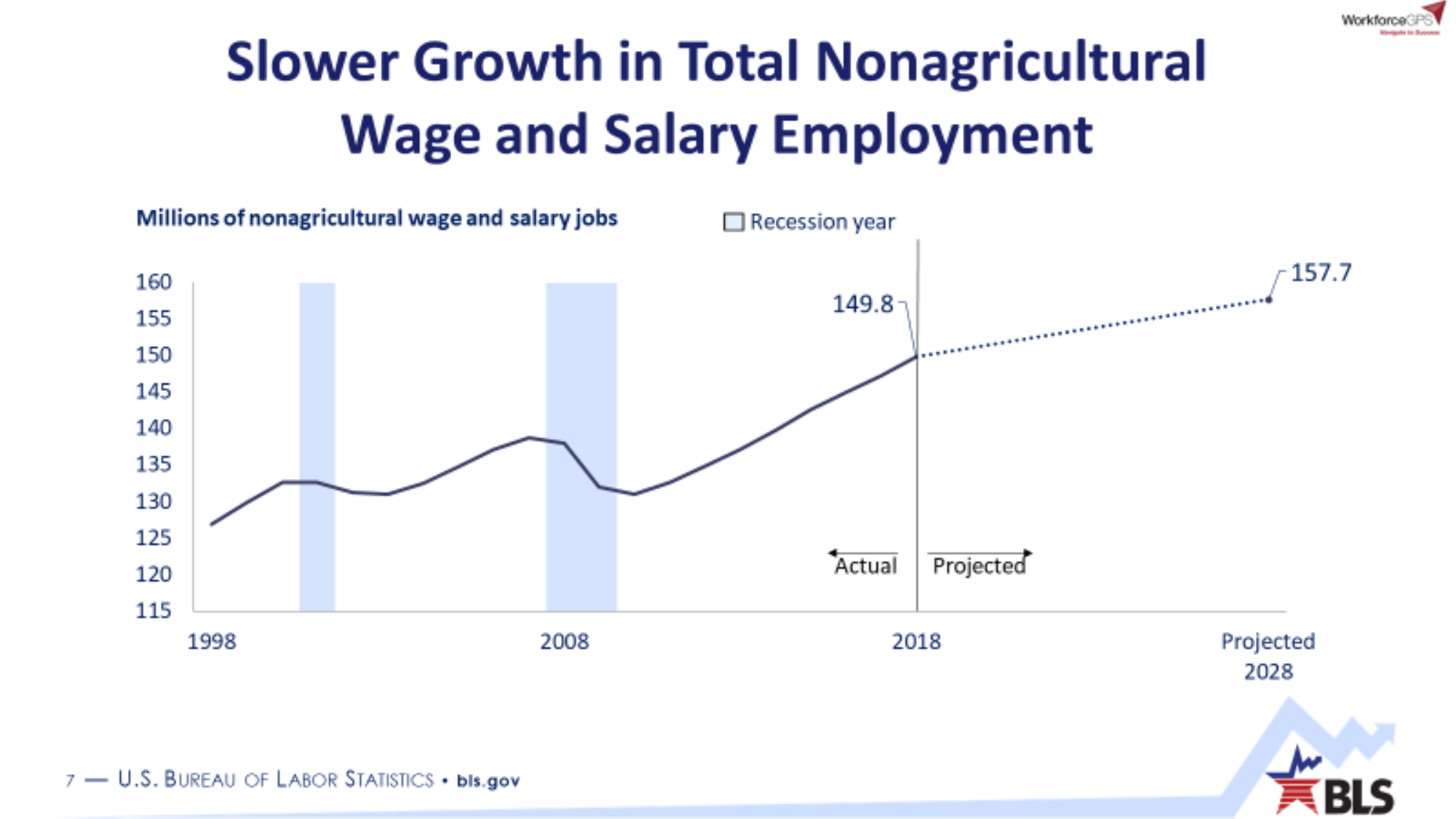
What is the difference between the projected 2028 value and the 2018 value? 7.9 Is the value for 2008 greater or less than 135? greater What is the projected value for 2028 on the chart? 157.7 How many shaded recession-year periods are shown on the chart? 2 Which is larger, the 2018 value or the projected 2028 value? Projected 2028 At which point on the x axis does the line reach its highest value? Projected 2028 At which year on the x axis is the line at its lowest value? 1998 What kind of chart is shown on the slide? Line chart Does the line rise or fall between 2018 and projected 2028? Rises What does the shaded legend entry on the chart represent? Recession year Is the value for 1998 greater or less than 130? less What is the value shown for 2018 on the chart? 149.8